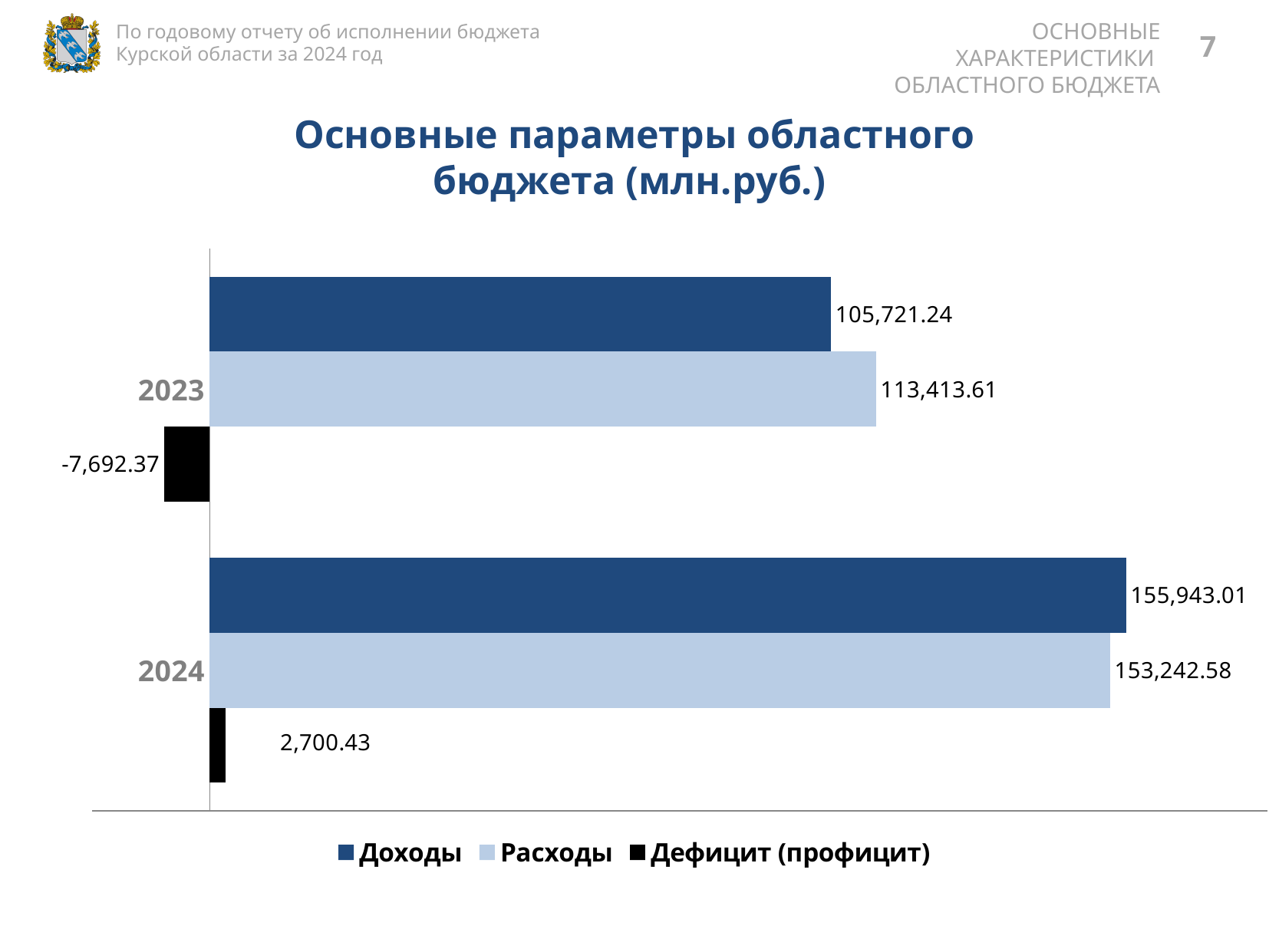
What is the value of Доходы for 2024? 155,943.01 What is the value of Расходы for 2023? 113,413.61 Which year has the lower value for Расходы? 2023 How many series does the legend list? 3 By how much did Доходы increase from 2023 to 2024? 50,221.77 What is the difference between Расходы in 2024 and Расходы in 2023? 39,828.97 What is the value of Дефицит (профицит) for 2024? 2,700.43 Which year has the higher value for Доходы? 2024 What is the title of the chart? Основные параметры областного бюджета (млн.руб.) In 2023, which is larger: Доходы or Расходы? Расходы What is the value of Дефицит (профицит) for 2023? -7,692.37 What kind of chart is shown on the slide? Bar chart